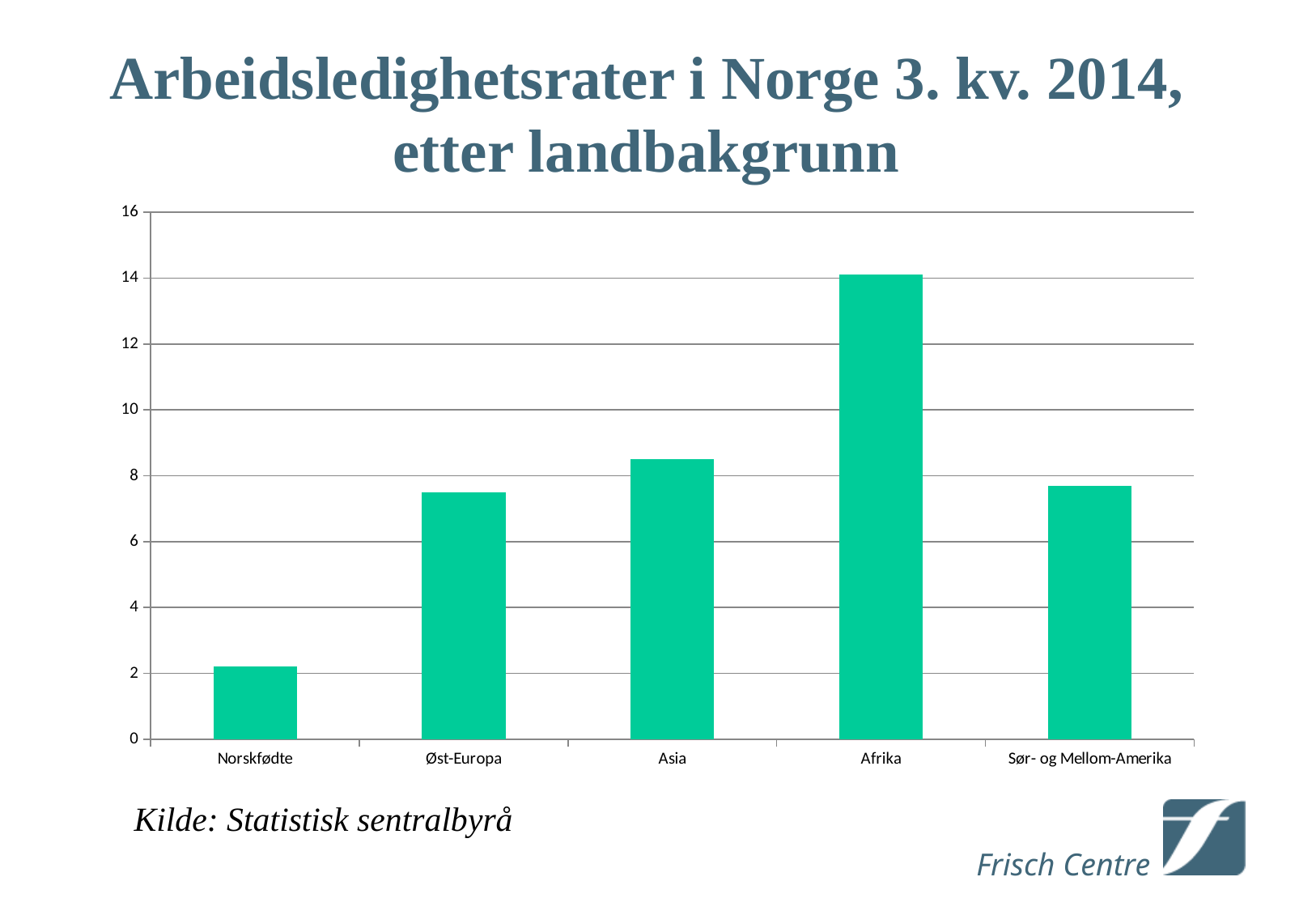
How many categories (country backgrounds) are shown on the x axis? 5 Which has the higher unemployment rate, Asia or Norskfødte? Asia Is the value for Norskfødte greater or less than 4? less Is the value for Asia greater or less than 8? greater Is the value for Øst-Europa greater or less than 8? less What kind of chart is shown on the slide? bar chart What is the title of the chart on the slide? Arbeidsledighetsrater i Norge 3. kv. 2014, etter landbakgrunn Which has the higher unemployment rate, Afrika or Asia? Afrika Which category has the lowest unemployment rate? Norskfødte Which category has the highest unemployment rate? Afrika